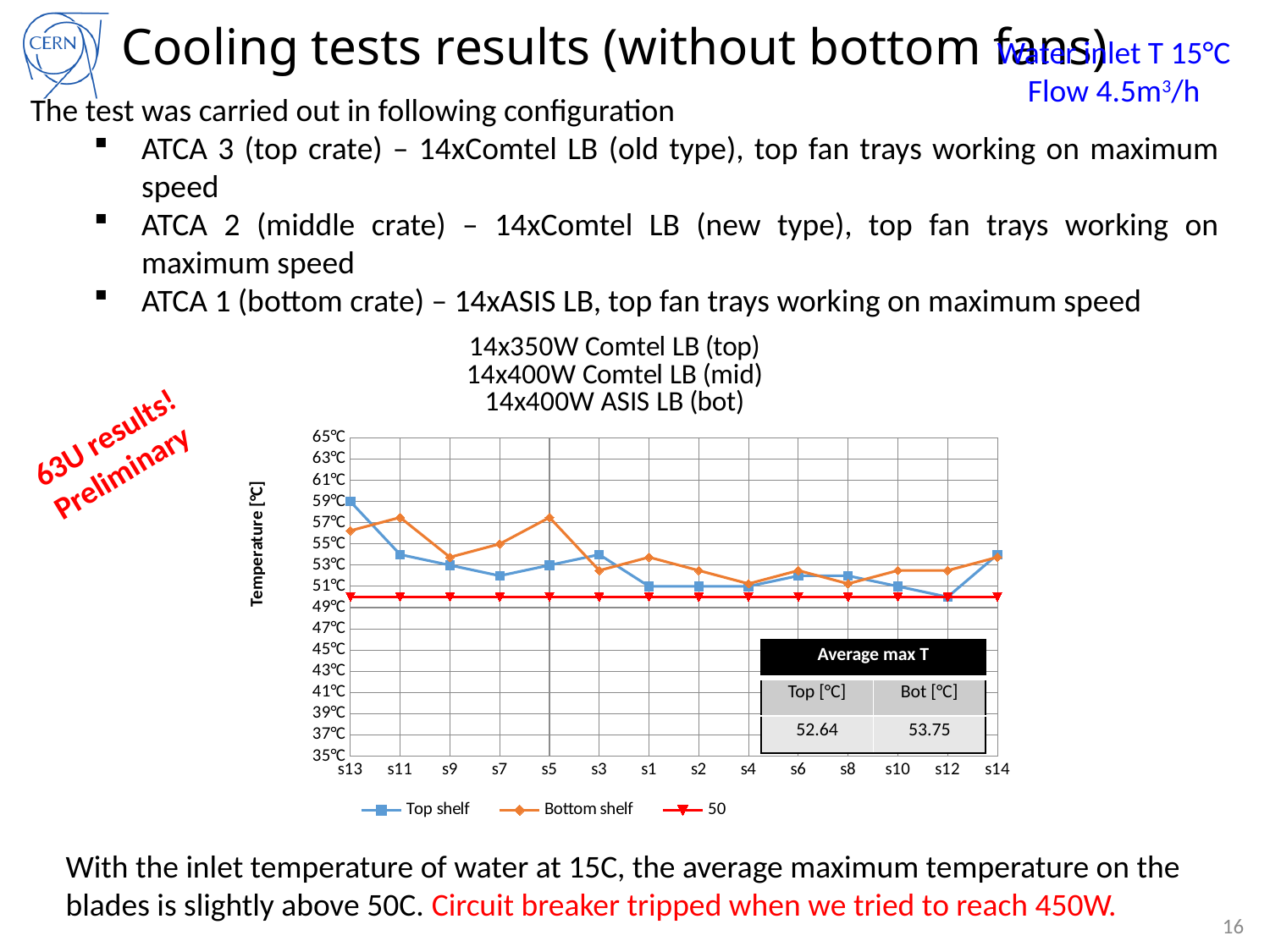
At s5, which series has the higher temperature, Top shelf or Bottom shelf? Bottom shelf What is the average max T for the Bot shelf shown in the table on the chart? 53.75 How many series does the chart legend list? 3 What is the label of the vertical axis of the chart? Temperature [°C] What is the average max T for the Top shelf shown in the table on the chart? 52.64 Is the Top shelf temperature at s12 greater or less than 53°C? less Which has the higher average max T in the table, Top or Bot? Bot What is the difference between the Bot and Top average max T values in the table? 1.11 How many slot categories are shown on the x axis of the chart? 14 At which slot does the Top shelf series reach its highest temperature? s13 Is the Top shelf temperature at s13 greater or less than 55°C? greater What kind of chart is shown on the slide? line chart